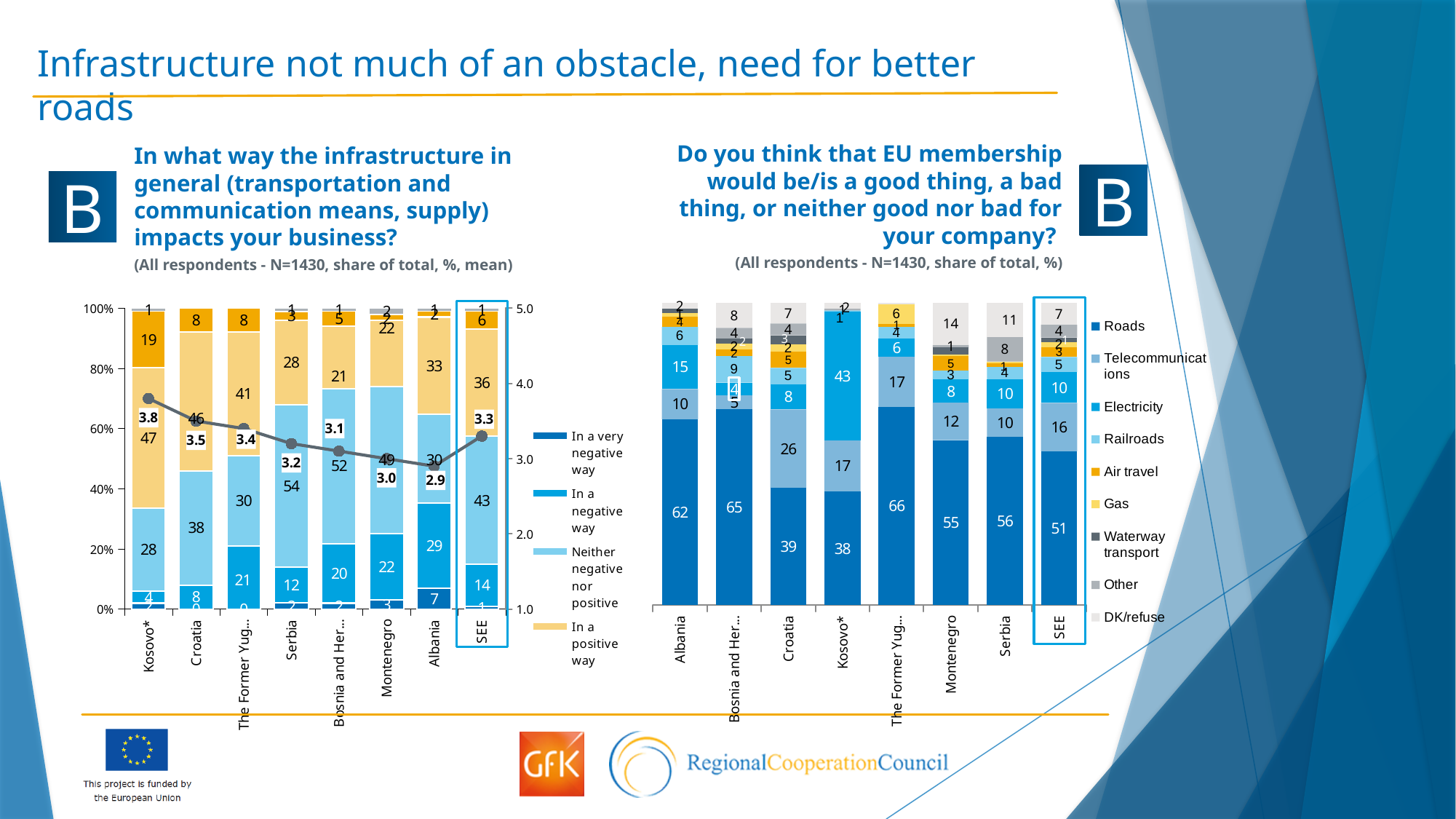
On the right chart, which country has the highest Electricity share? Kosovo* On the right chart, what is the Roads share for Croatia? 39 On the left chart (infrastructure impact on business), which country has the lowest mean value on the line? Albania On the left chart (infrastructure impact on business), which country has the highest mean value on the line? Kosovo* On the left chart (infrastructure impact on business), what is the mean value shown for Kosovo*? 3.8 On the right chart, what is the difference between the Roads share for Albania and for Croatia? 23 On the right chart, how many countries/regions are shown on the x axis? 8 On the left chart (infrastructure impact on business), what is the 'Neither negative nor positive' share for SEE? 43 On the right chart, how many series does the legend list? 9 On the left chart (infrastructure impact on business), does the mean line rise or fall from Kosovo* to Albania? fall On the left chart (infrastructure impact on business), what is the 'In a positive way' share for Serbia? 28 On the right chart, which has the larger Telecommunications share, Croatia or Kosovo*? Croatia